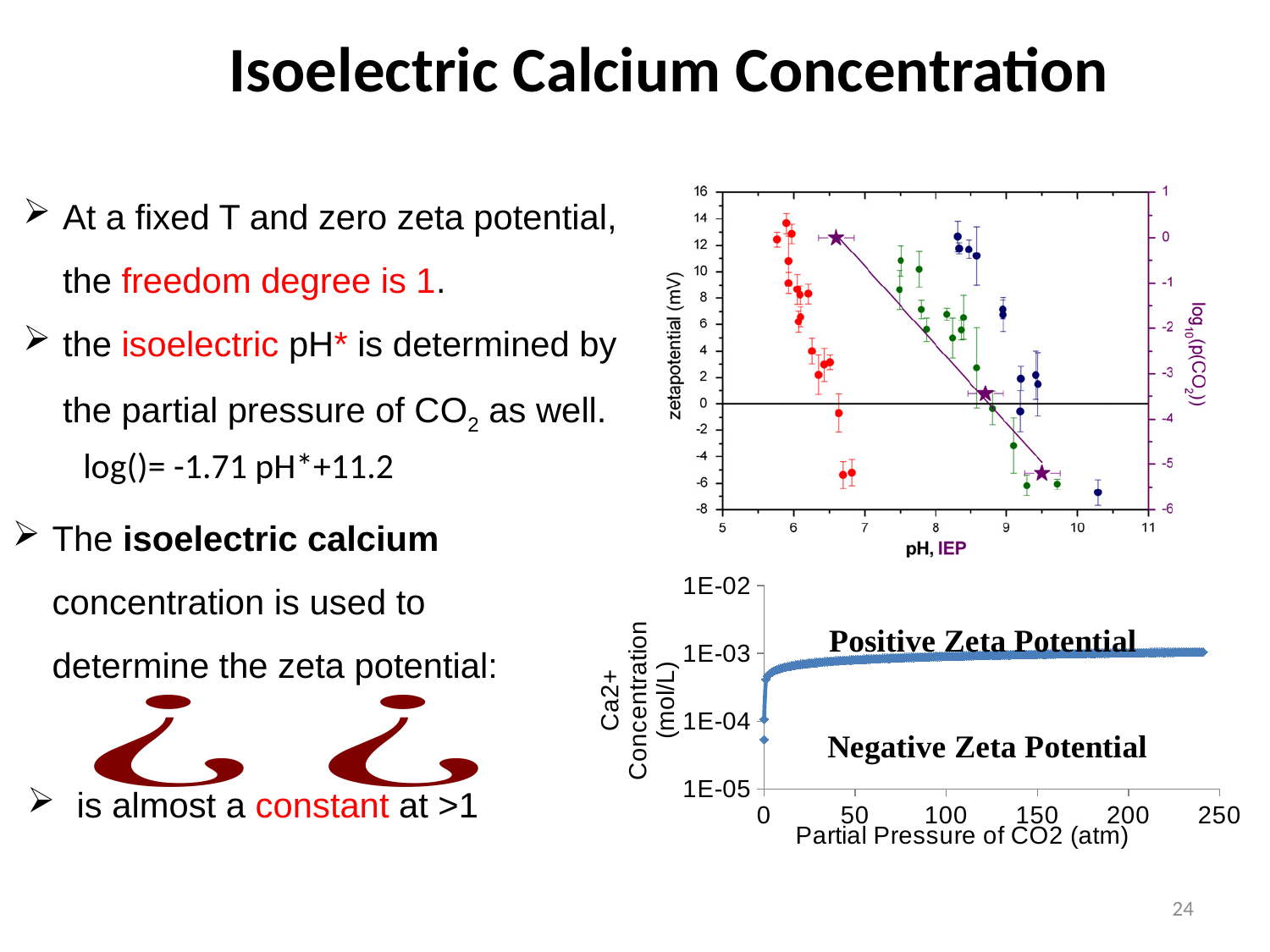
In the bottom-right chart, which region is labelled above the plotted curve: positive or negative zeta potential? Positive Zeta Potential In the top-right chart, what is the label of the x axis? pH, IEP In the bottom-right chart, how does the Ca2+ concentration change as the partial pressure of CO2 increases from 0 to about 250 atm? rises steeply at first, then stays almost constant In the top-right chart, how many purple star (IEP) markers are plotted? 3 In the top-right chart, what is the maximum value shown on the left zeta potential axis? 16 In the top-right chart, do the purple star (IEP) markers rise or fall as pH increases? fall In the top-right chart, is the zeta potential of the red data points near pH 5.8 greater or less than 10 mV? greater In the bottom-right chart, is the Ca2+ concentration at a partial pressure of 200 atm greater or less than 1E-02 mol/L? less In the top-right chart, is the zeta potential of the blue data point near pH 10.3 greater or less than -5 mV? less What kind of chart is the bottom-right chart of Ca2+ concentration versus partial pressure of CO2? scatter (line) chart